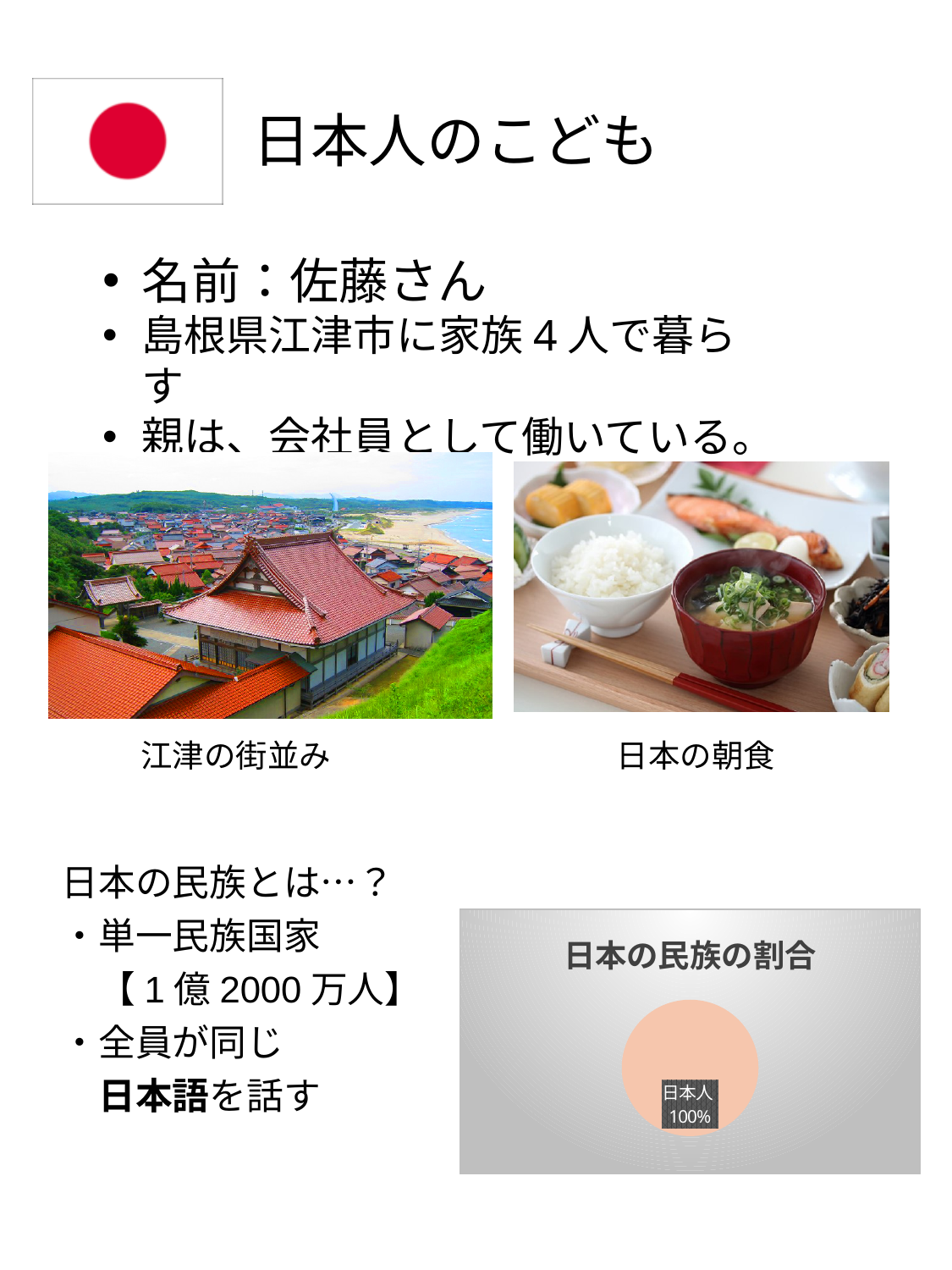
What is the title of the chart on the slide? 日本の民族の割合 What share of the pie chart does 日本人 represent? 100% What is the label of the only slice in the pie chart? 日本人 How many slices does the pie chart have? 1 What value is printed on the 日本人 slice of the pie chart? 100% Which category has the largest share in the pie chart? 日本人 What kind of chart is shown on the slide? pie chart